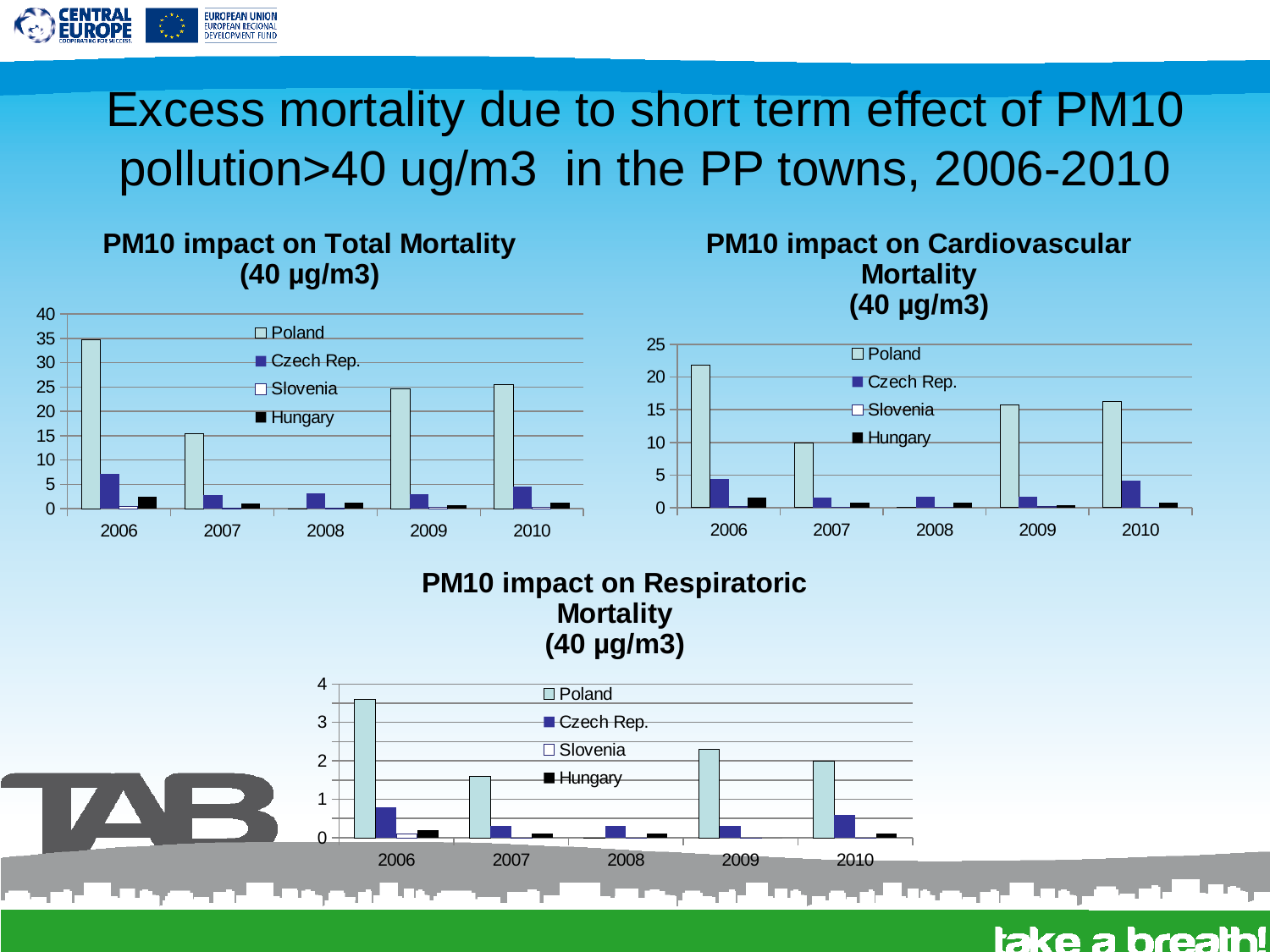
What kind of chart is the 'PM10 impact on Respiratoric Mortality' chart? bar chart In the 'PM10 impact on Respiratoric Mortality' chart, is the value for Czech Rep. in 2006 greater or less than 1? less In the 'PM10 impact on Respiratoric Mortality' chart, is the value for Poland in 2006 greater or less than 3? greater In the 'PM10 impact on Total Mortality' chart, is the value for Poland in 2006 greater or less than 30? greater In the 'PM10 impact on Total Mortality' chart, which year has the highest value for Poland? 2006 How many series does the legend of the 'PM10 impact on Total Mortality' chart list? 4 How many years are shown on the x axis of the 'PM10 impact on Total Mortality' chart? 5 In the 'PM10 impact on Cardiovascular Mortality' chart, which is larger for Poland: the value in 2006 or the value in 2010? 2006 In the 'PM10 impact on Respiratoric Mortality' chart, which year has the highest value for Poland? 2006